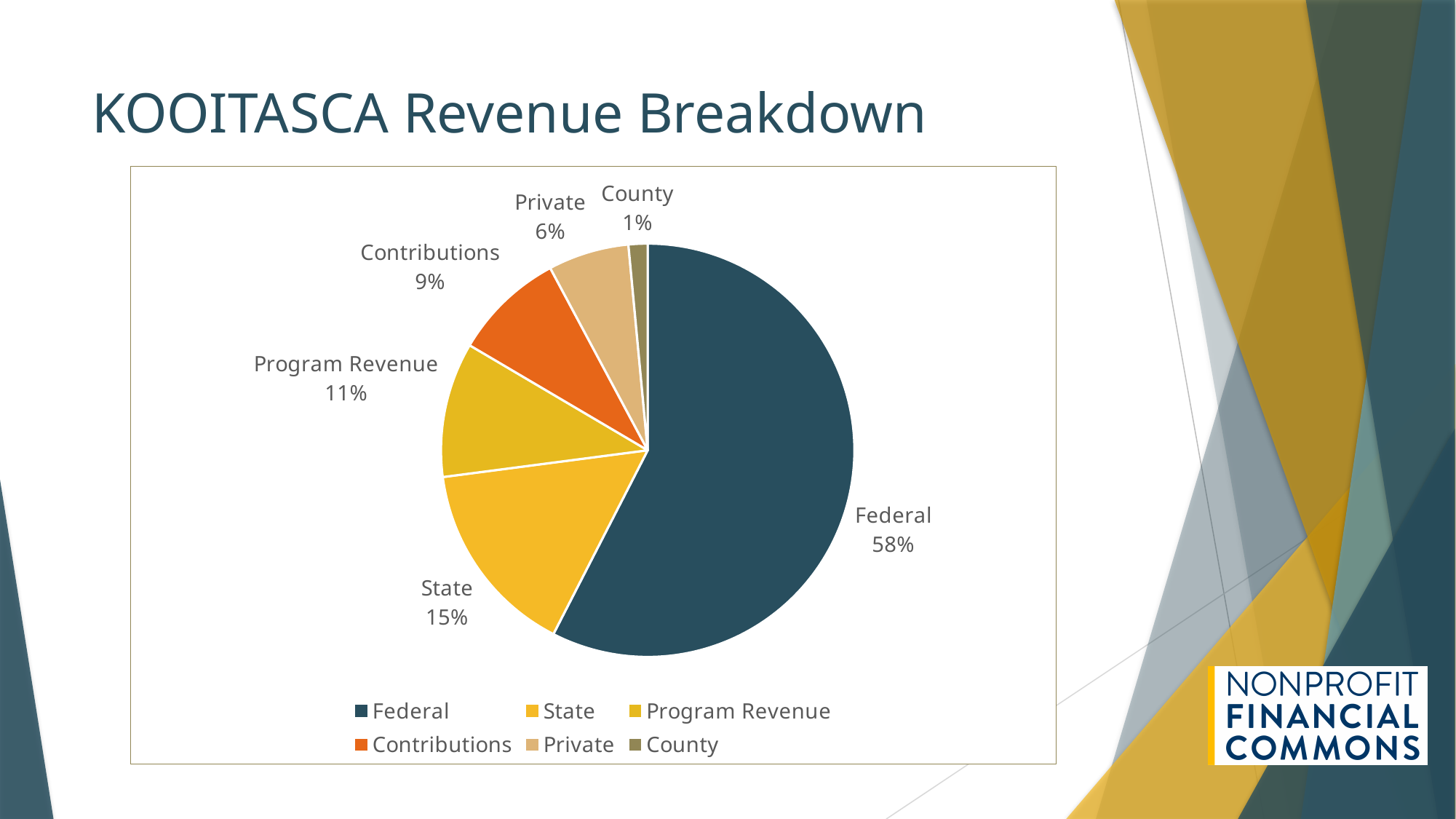
What share of revenue comes from Federal sources? 58% Which is larger, the Contributions share or the Private share? Contributions Which revenue source has the largest share of the pie? Federal Which revenue source has the smallest share of the pie? County What percentage of revenue is from State sources? 15% What percentage of revenue comes from Contributions? 9% What is the difference in percentage points between the Federal and State shares? 43 What is the title of the slide containing the chart? KOOITASCA Revenue Breakdown What share of revenue is Program Revenue? 11% How many slices does the pie chart have? 6 What kind of chart is shown on the slide? Pie chart What share of revenue comes from Private sources? 6%